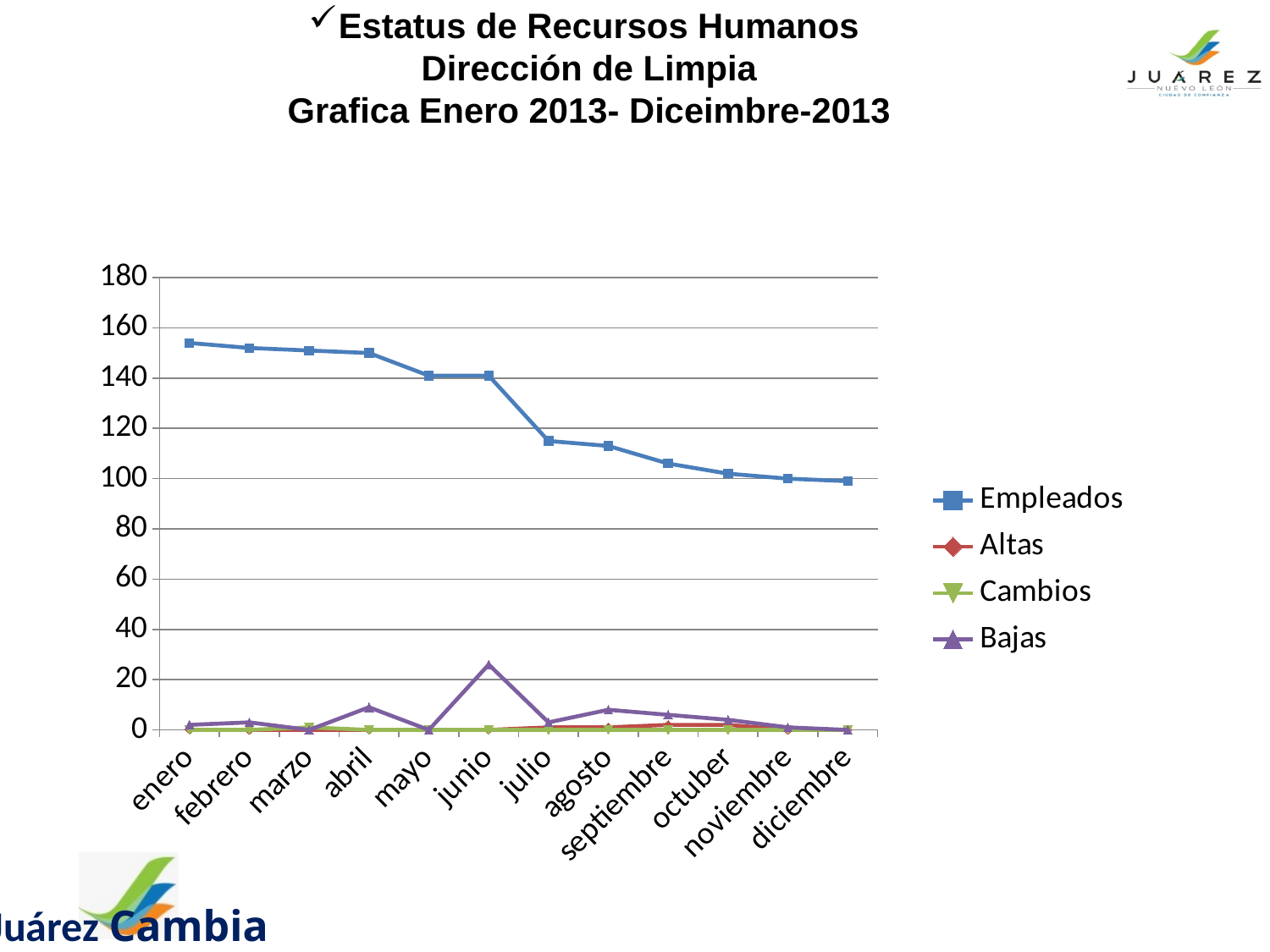
Does the Empleados series rise or fall from enero to diciembre? fall In which month is the Bajas value highest? junio Is the Empleados value for enero greater or less than 140? greater In which month is the Empleados value highest? enero Which series is shown with a blue line and square markers? Empleados Is the Empleados value for julio greater or less than 120? less Is the Bajas value for junio greater or less than 20? greater How many series does the legend list? 4 How many months are plotted along the x axis? 12 What kind of chart is shown on the slide? line chart Which is larger, the Empleados value for enero or for diciembre? enero Which is larger, the Empleados value for mayo or for julio? mayo